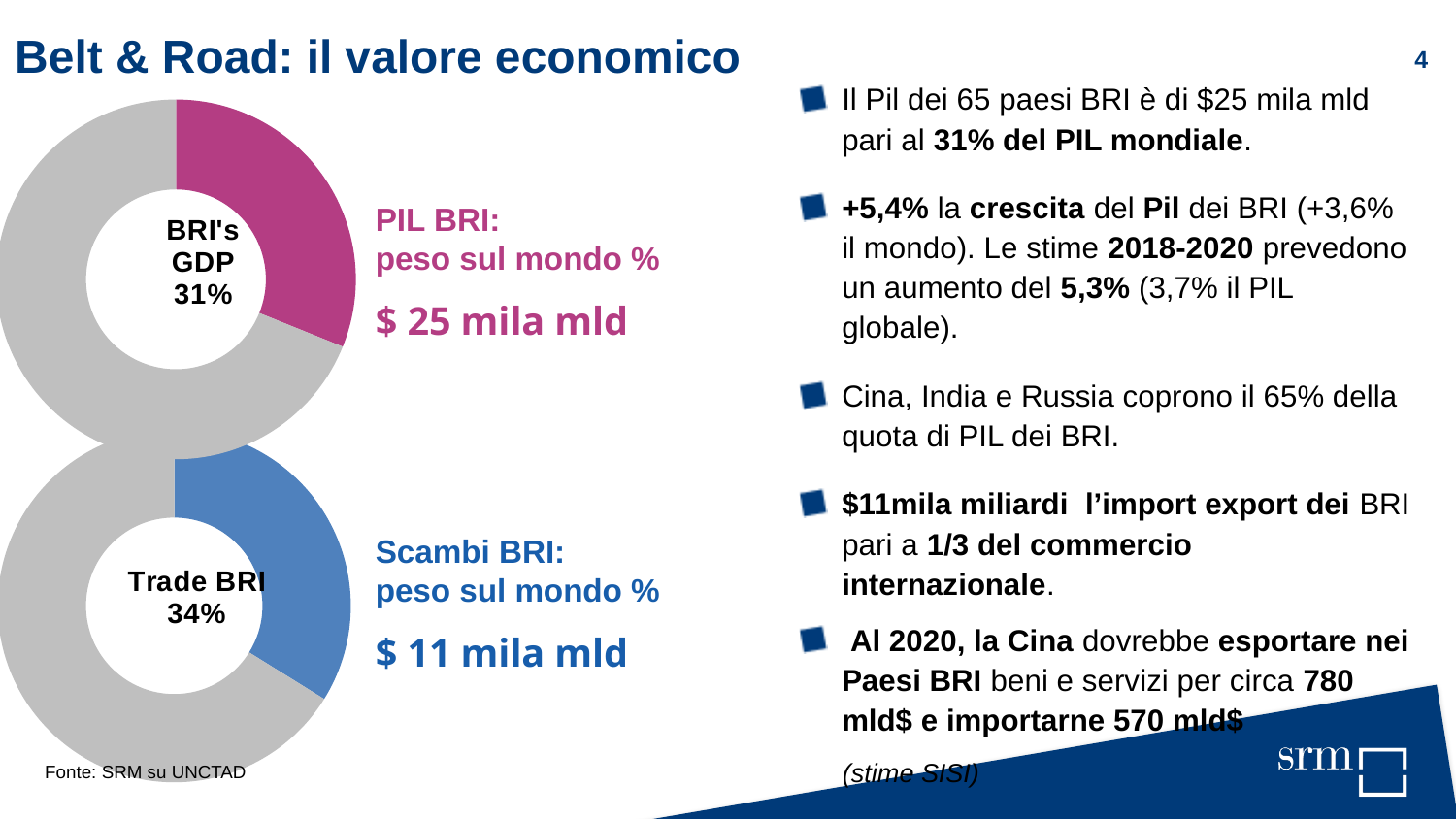
In the bottom doughnut chart, what share of the ring is not covered by Trade BRI? 66% What is the difference in percentage points between the Trade BRI share (bottom chart) and the BRI's GDP share (top chart)? 3 percentage points In the top doughnut chart, what share of the ring is not covered by BRI's GDP? 69% Which is larger: the BRI's GDP share (top chart) or the Trade BRI share (bottom chart)? Trade BRI (34%) In the bottom doughnut chart, what share of world trade is attributed to Trade BRI? 34% What kind of chart is used to show BRI's GDP share on the slide? Doughnut (pie) chart What source is cited for the charts on the slide? SRM su UNCTAD How many segments does each doughnut chart on the slide have? 2 What dollar value is printed next to the bottom doughnut chart (Scambi BRI)? $ 11 mila mld What dollar value is printed next to the top doughnut chart (PIL BRI)? $ 25 mila mld What colour is the highlighted segment in the bottom doughnut chart (Trade BRI)? Blue In the top doughnut chart, what share of world GDP is attributed to BRI's GDP? 31%